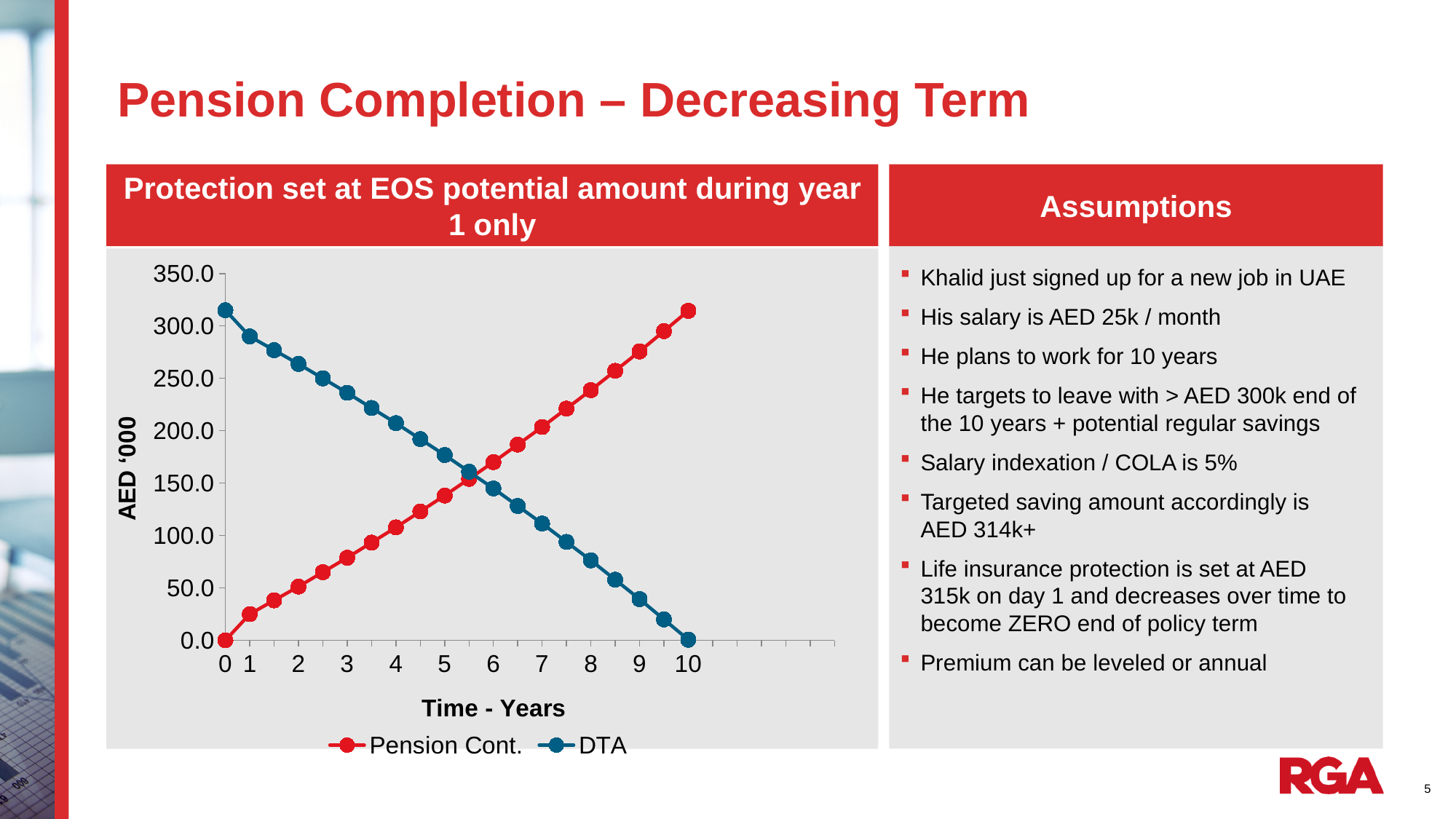
What kind of chart is shown on the slide? line chart How many series does the chart legend list? 2 Does the Pension Cont. series rise or fall as time increases along the x axis? rise Is the value for Pension Cont. at year 10 greater or less than 300.0? greater Does the DTA series rise or fall as time increases along the x axis? fall What is the title of the chart's vertical axis? AED '000 Is the value for DTA at year 8 greater or less than 100.0? less At year 8, which series has the larger value, Pension Cont. or DTA? Pension Cont. At year 2, which series has the larger value, Pension Cont. or DTA? DTA Is the value for DTA at year 0 greater or less than 300.0? greater What is the value of Pension Cont. at year 0? 0.0